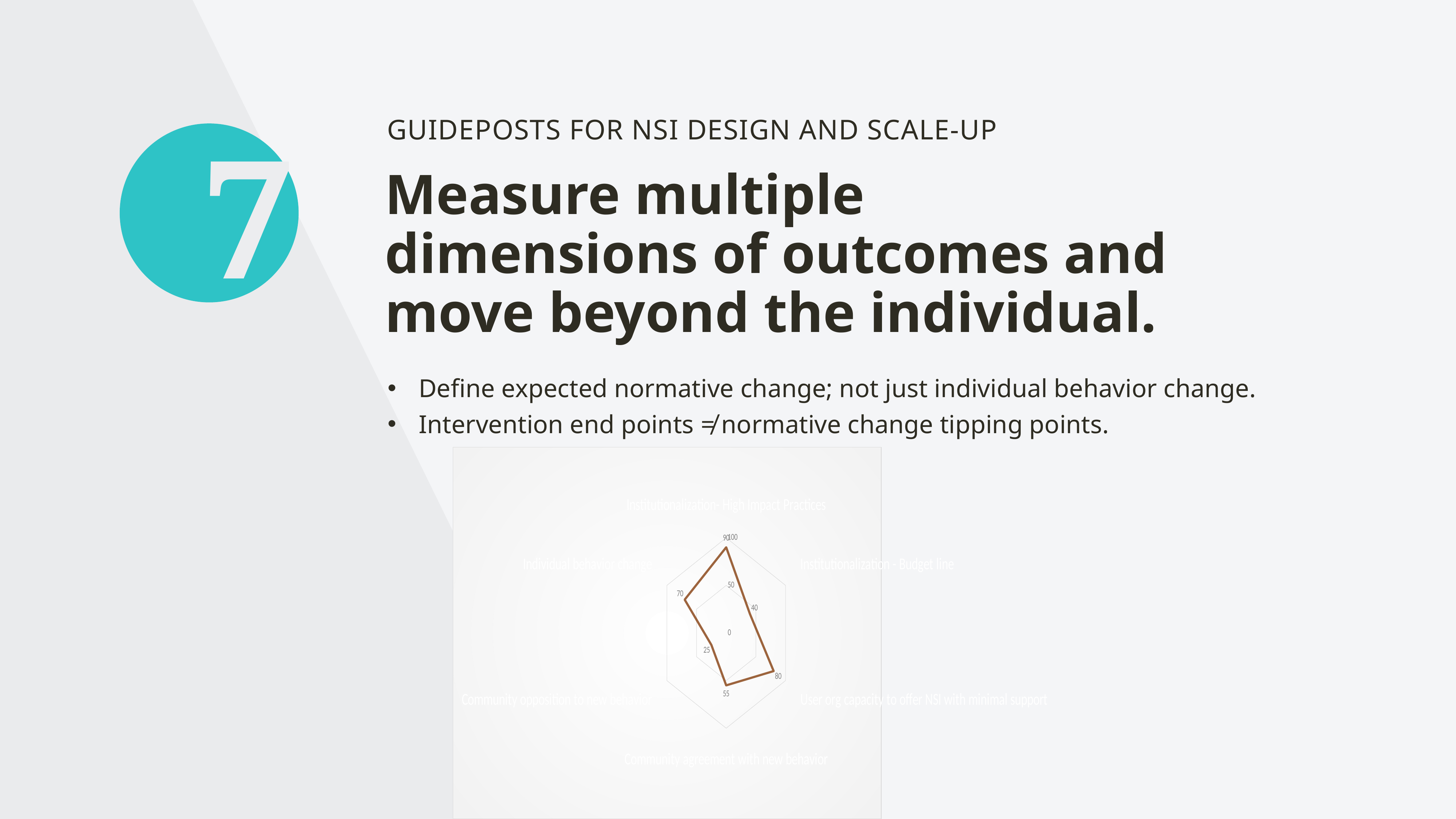
How many categories (axes) does the radar chart have? 6 Which category has the highest value? Institutionalization- High Impact Practices What kind of chart is shown on the slide? Radar chart Which is larger: the value for Individual behavior change or the value for User org capacity to offer NSI with minimal support? User org capacity to offer NSI with minimal support What is the value for User org capacity to offer NSI with minimal support? 80 Which category has the lowest value? Community opposition to new behavior What is the difference between the values for Institutionalization- High Impact Practices and Community opposition to new behavior? 65 What is the value for Community opposition to new behavior? 25 What is the value for Community agreement with new behavior? 55 What is the value for Individual behavior change? 70 What is the value for Institutionalization- High Impact Practices? 90 What is the value for Institutionalization - Budget line? 40